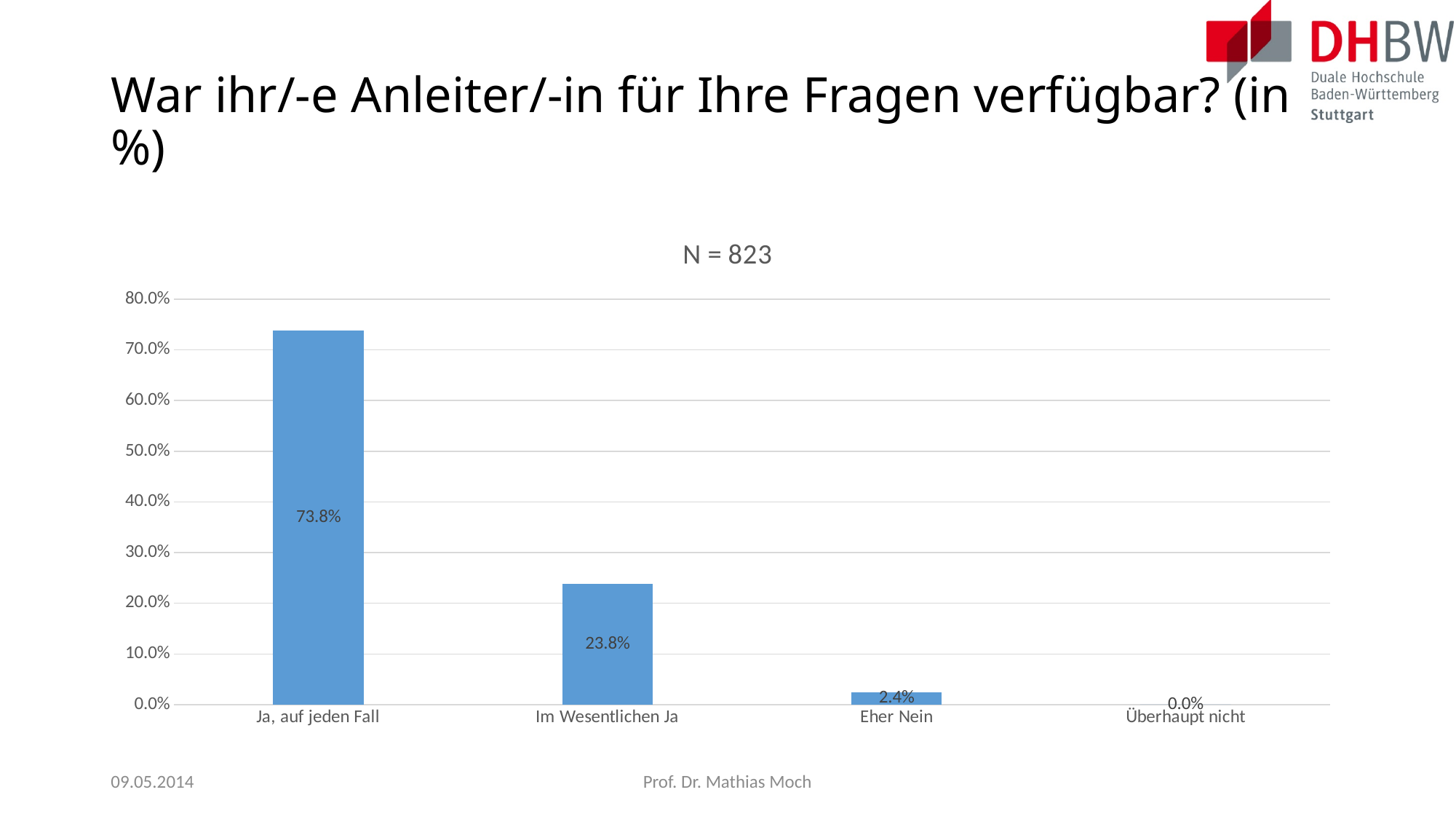
What is the value for "Eher Nein"? 2.4% Is the value for "Ja, auf jeden Fall" greater or less than 70.0%? greater What is the value for "Ja, auf jeden Fall"? 73.8% Which category has the lowest value? Überhaupt nicht What kind of chart is shown on the slide? Bar chart What is the chart title shown above the plot area? N = 823 What is the value for "Überhaupt nicht"? 0.0% What is the value for "Im Wesentlichen Ja"? 23.8% Which is larger, the value for "Im Wesentlichen Ja" or the value for "Eher Nein"? Im Wesentlichen Ja How many categories are shown on the x axis? 4 Which category has the highest value? Ja, auf jeden Fall What is the difference between the values for "Ja, auf jeden Fall" and "Im Wesentlichen Ja"? 50.0%